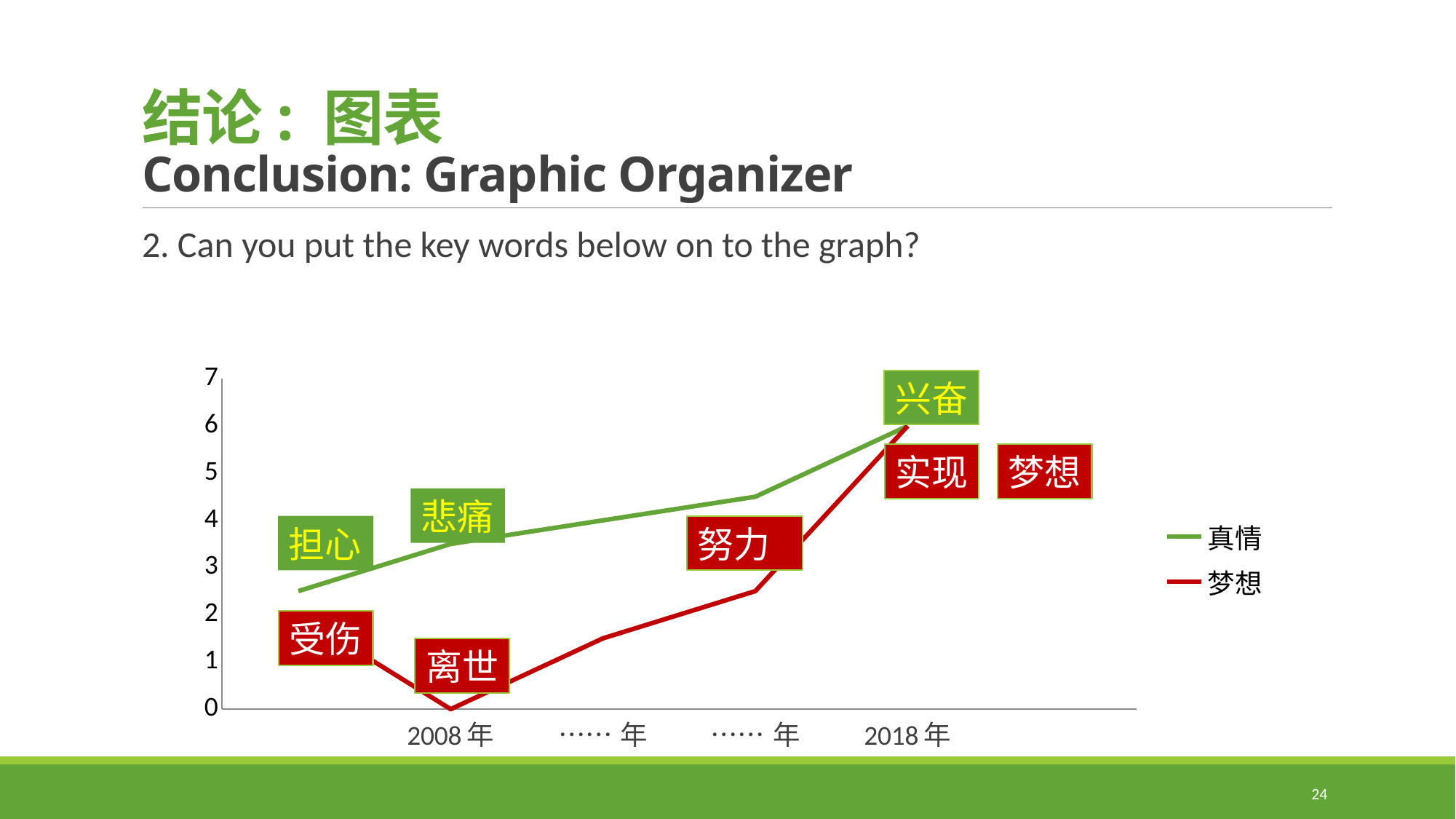
Is the value of the 梦想 series at 2018 年 greater or less than 5? greater How many labels are shown along the x axis? 4 At which x-axis label does the 真情 series reach its highest value? 2018 年 What are the two series named in the legend? 真情 and 梦想 Does the 真情 series rise or fall from 2008 年 to 2018 年? rise At 2008 年, which series has the larger value, 真情 or 梦想? 真情 At which x-axis label does the 梦想 series reach its lowest value? 2008 年 What is the value of the 梦想 series at 2008 年? 0 What kind of chart is shown on the slide? line chart Is the value of the 真情 series at 2008 年 greater or less than 3? greater What colour is the line for the 梦想 series? red How many series does the legend list? 2